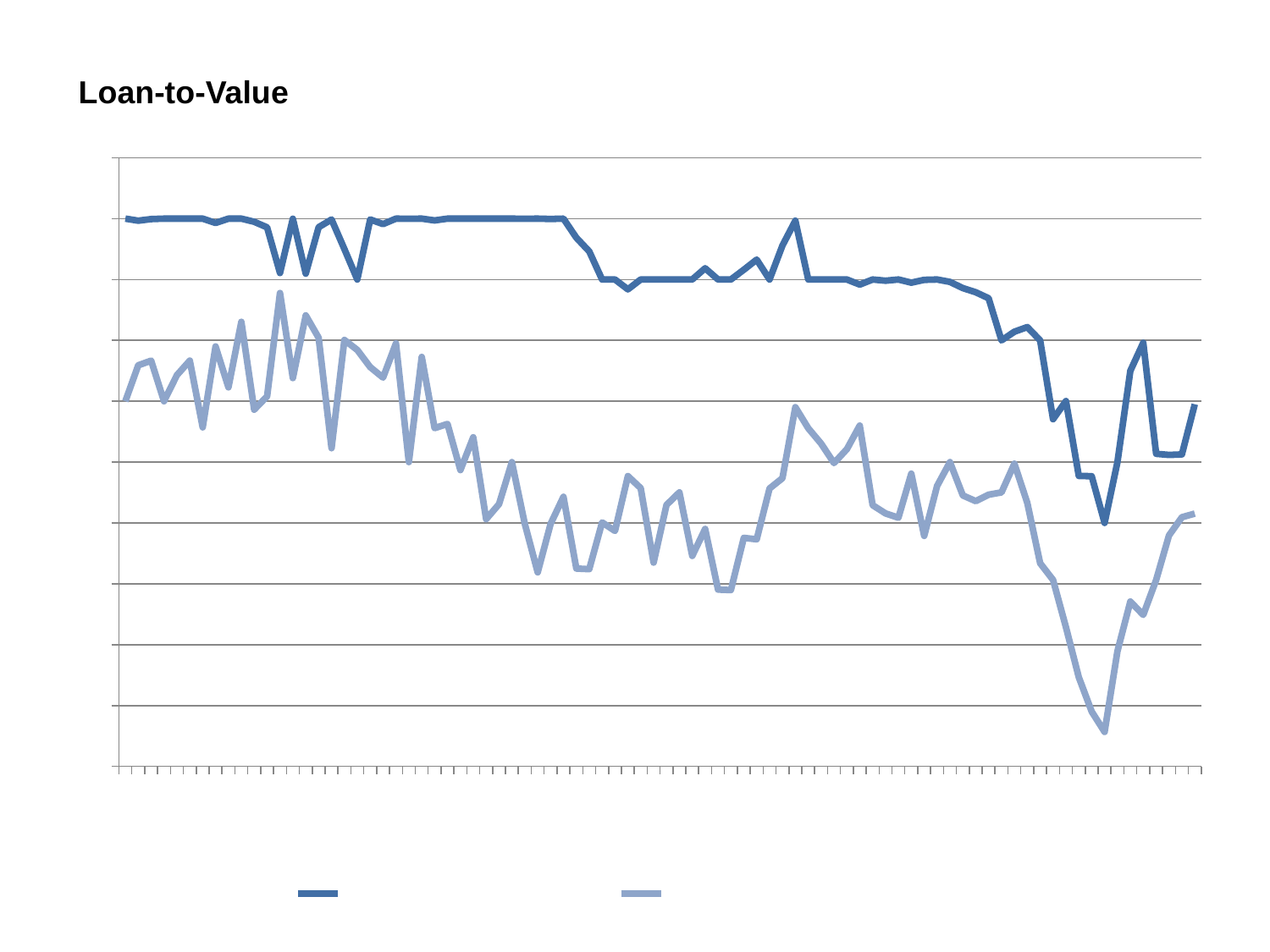
What kind of chart is shown on the slide? line chart Does the dark blue line generally rise or fall from left to right? fall Which series is plotted higher on the chart, the dark blue line or the light blue line? the dark blue line What is the title of the chart? Loan-to-Value Which series reaches the lowest point on the chart, the dark blue line or the light blue line? the light blue line Does the light blue line generally rise or fall from left to right? fall How many series does the legend list? 2